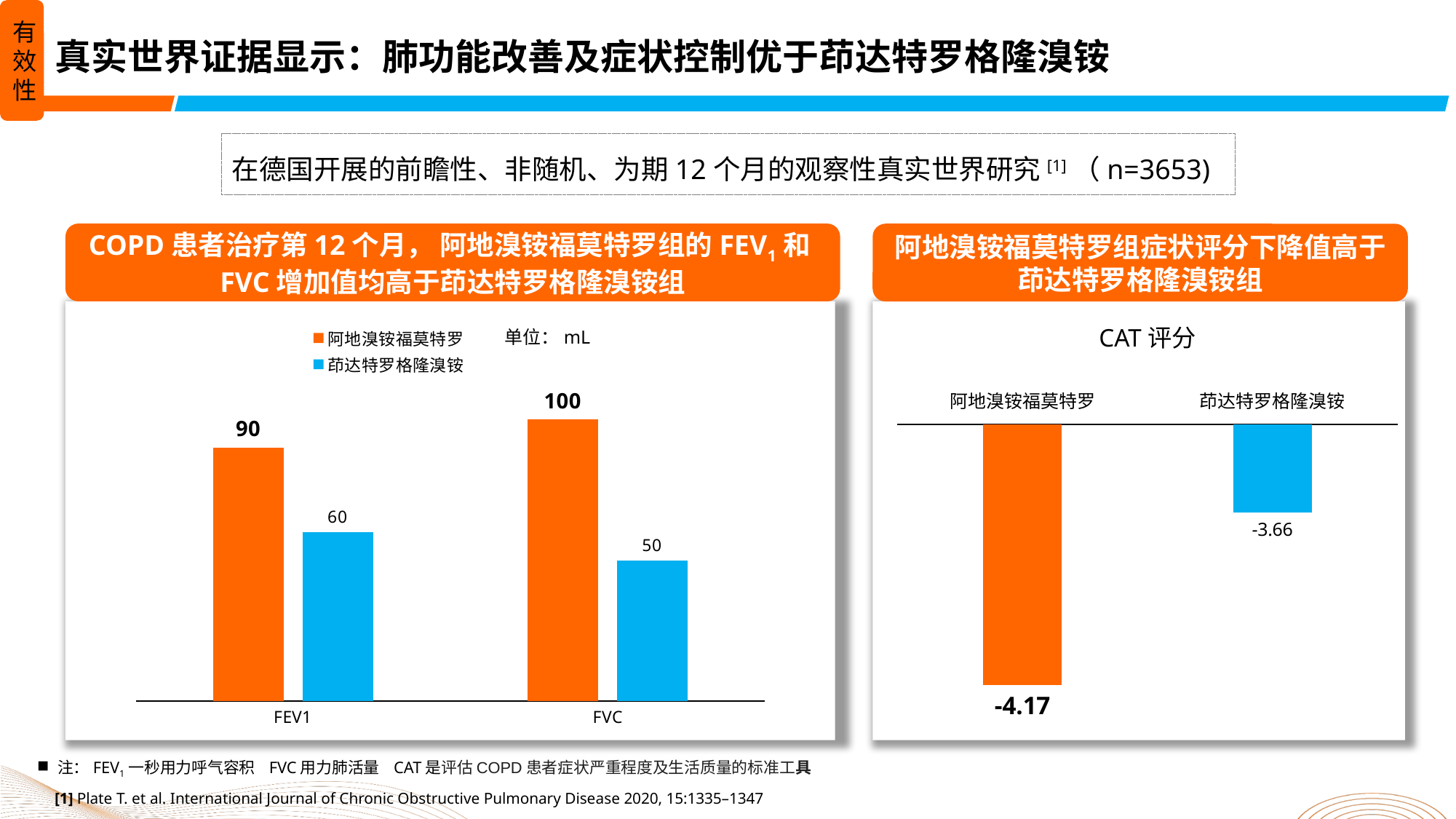
In the right chart (CAT 评分), which group has the lowest value? 阿地溴铵福莫特罗 In the left chart, how many categories are shown on the x axis? 2 In the left chart, what is the difference between the FEV1 values of 阿地溴铵福莫特罗 and 茚达特罗格隆溴铵? 30 In the right chart (CAT 评分), what is the value for 阿地溴铵福莫特罗? -4.17 In the left chart, what is the FEV1 value for 阿地溴铵福莫特罗? 90 In the left chart, what is the FVC value for 阿地溴铵福莫特罗? 100 What kind of chart is the right chart (CAT 评分)? bar chart In the left chart, what unit is stated for the values? mL In the left chart, what is the FVC value for 茚达特罗格隆溴铵? 50 In the left chart, how many series does the legend list? 2 In the right chart (CAT 评分), what is the value for 茚达特罗格隆溴铵? -3.66 In the left chart, which series has the higher FVC value? 阿地溴铵福莫特罗